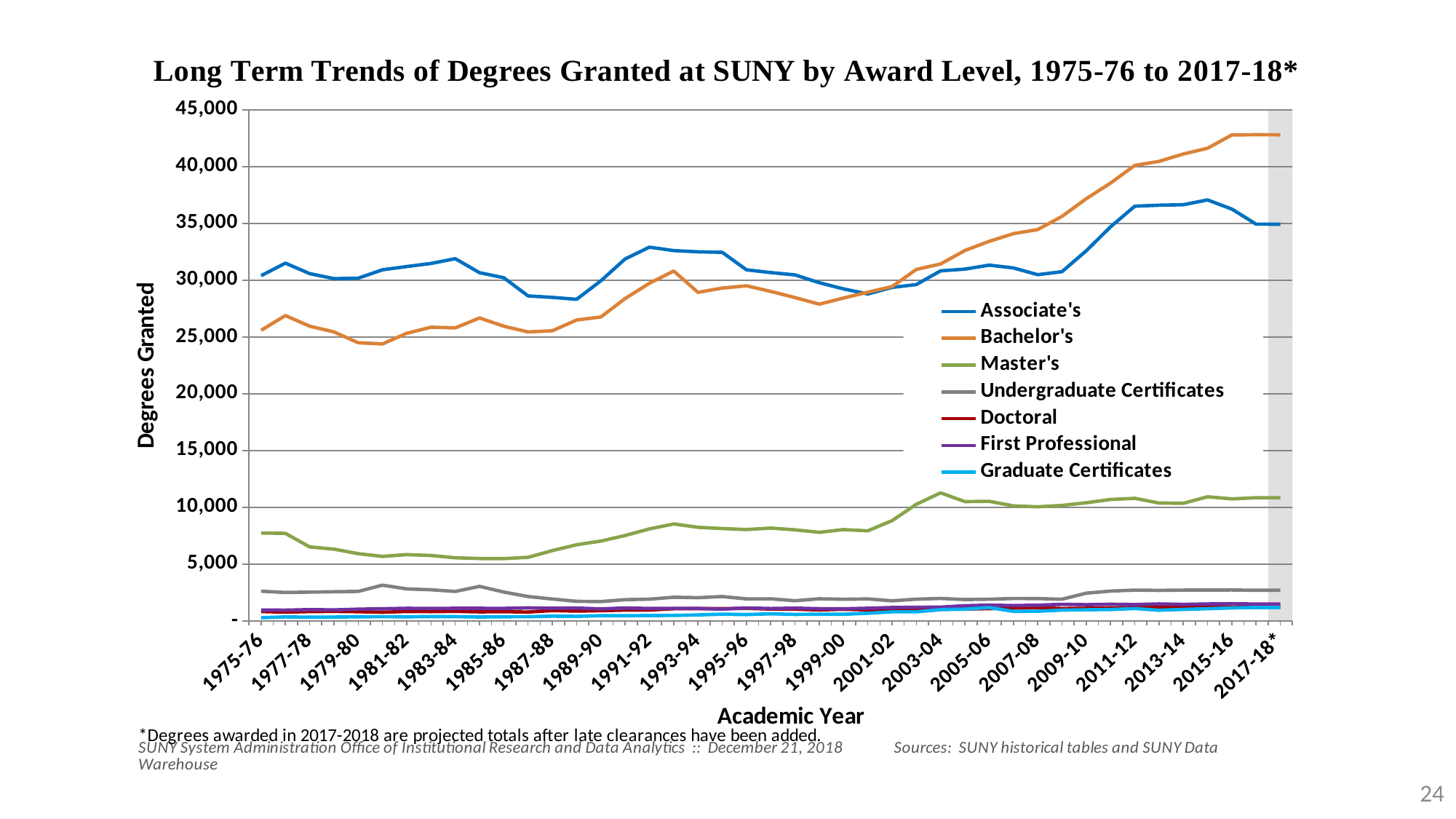
Is the value for Bachelor's in 2017-18* greater or less than 40,000? greater How many series does the legend list? 7 Is the value for Undergraduate Certificates in 2017-18* greater or less than 5,000? less Does the Bachelor's line rise or fall from 2001-02 to 2017-18*? rises Which award level has the highest number of degrees granted in 2017-18*? Bachelor's Is the value for Master's in 1985-86 greater or less than 10,000? less What kind of chart is shown on the slide? line chart Which award level has the highest number of degrees granted in 1975-76? Associate's What is the title of the x axis? Academic Year Which award level has the lowest number of degrees granted in 1975-76? Graduate Certificates In 2009-10, which is larger: Associate's or Bachelor's? Bachelor's